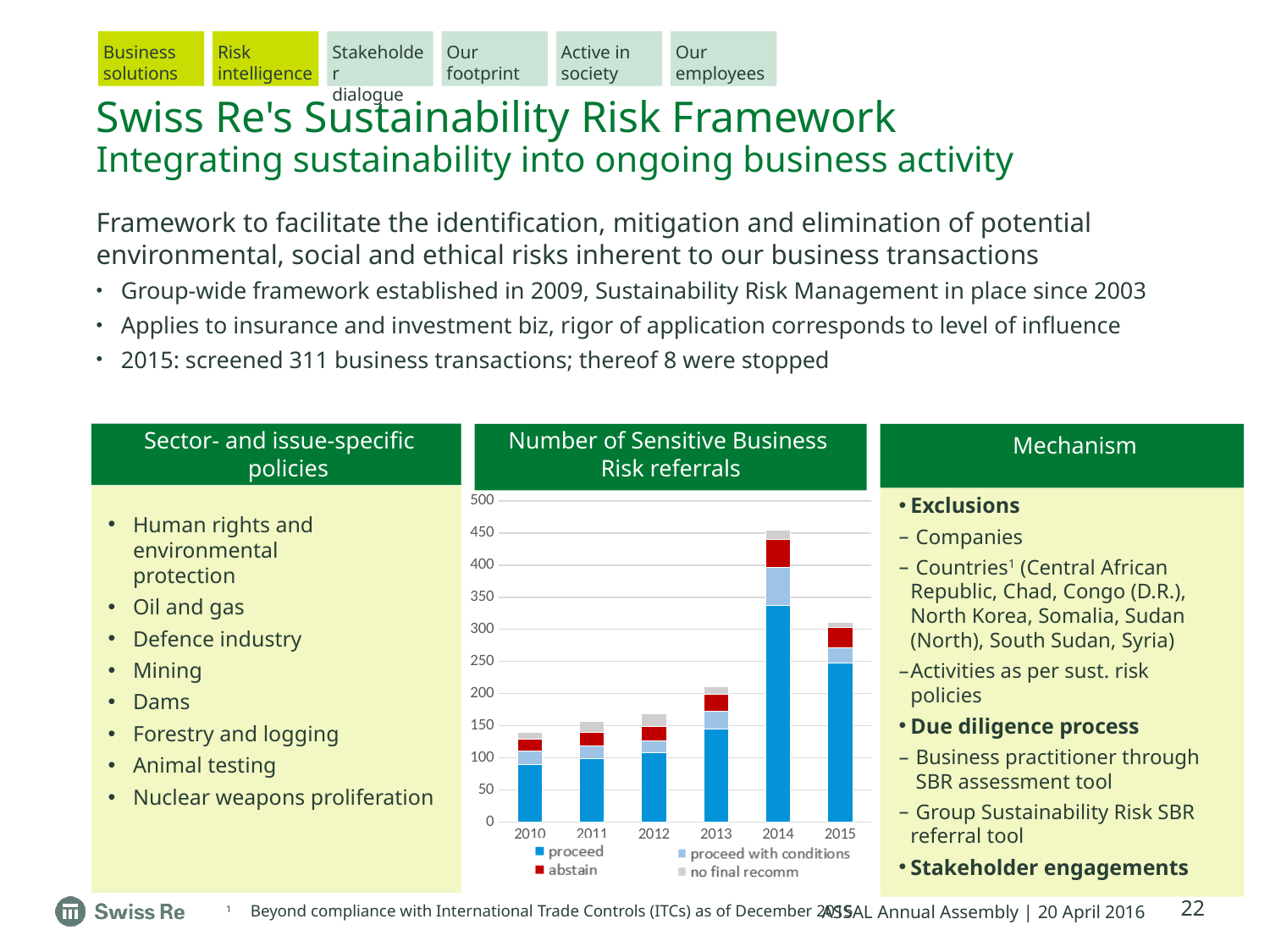
What kind of chart is shown under 'Number of Sensitive Business Risk referrals'? stacked bar chart In the 'Number of Sensitive Business Risk referrals' chart, which year has the tallest bar? 2014 In the 'Number of Sensitive Business Risk referrals' chart, is the total bar for 2015 greater or less than 250? greater In the 'Number of Sensitive Business Risk referrals' chart, is the total bar for 2014 greater or less than 400? greater How many years are shown on the x axis of the 'Number of Sensitive Business Risk referrals' chart? 6 In the 'Number of Sensitive Business Risk referrals' chart, do the total bars rise or fall from 2010 to 2014? rise How many series does the legend of the 'Number of Sensitive Business Risk referrals' chart list? 4 In the 'Number of Sensitive Business Risk referrals' chart, is the 'proceed' segment for 2014 greater or less than 300? greater Which series in the 'Number of Sensitive Business Risk referrals' chart is shown in red? abstain In the 'Number of Sensitive Business Risk referrals' chart, which year has the taller bar, 2014 or 2015? 2014 In the 'Number of Sensitive Business Risk referrals' chart, which year has the shortest bar? 2010